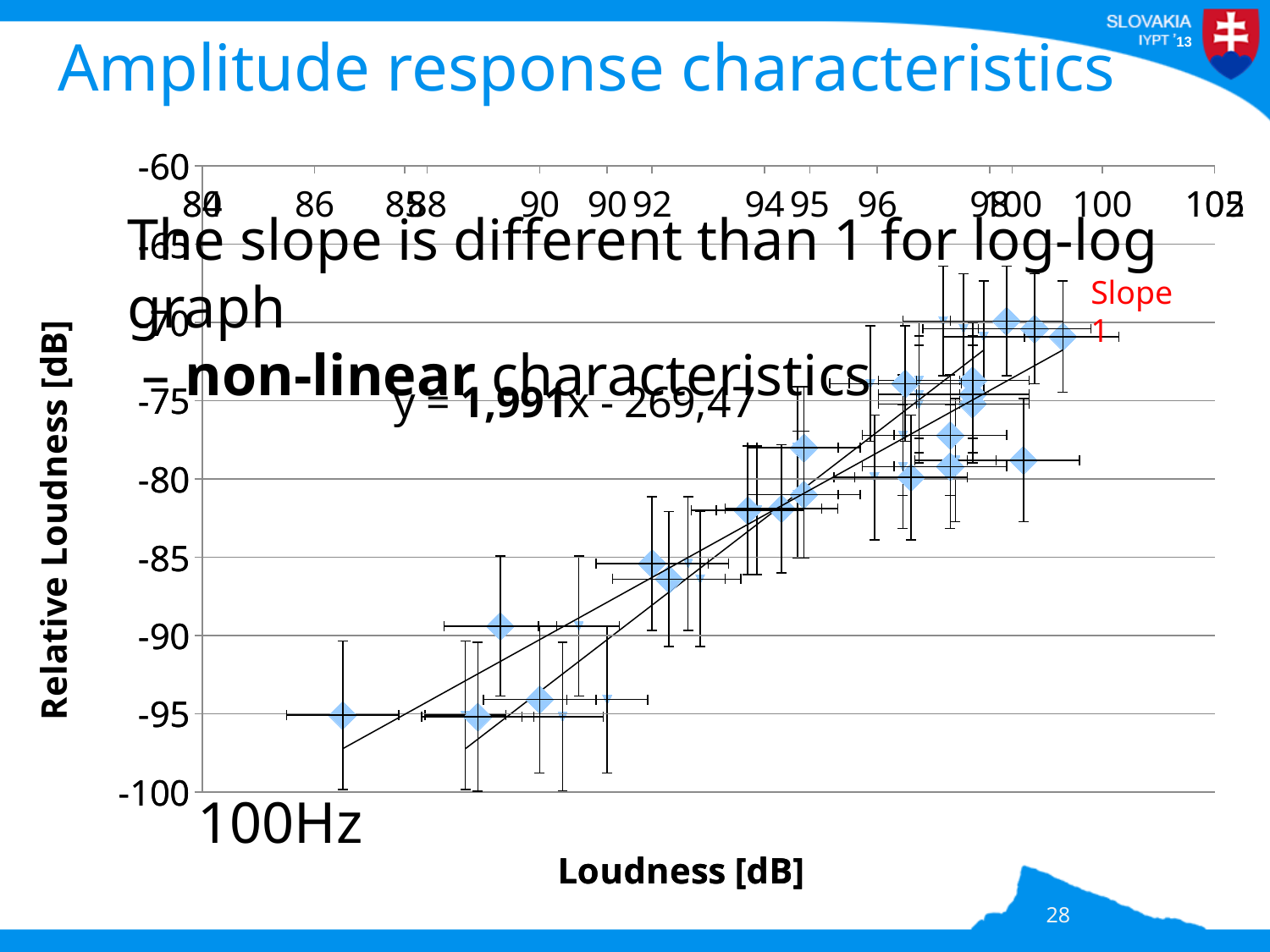
Do the plotted relative loudness values rise or fall as loudness increases along the x axis? rise Is the relative loudness of the leftmost data point greater or less than -90? less What is the highest tick value shown on the vertical axis? -60 What is the slope of the fitted trendline shown in the equation on the chart? 1,991 What is the lowest tick value shown on the vertical axis? -100 Which frequency is the chart labelled with? 100Hz Is the relative loudness of the rightmost data point greater or less than -75? greater What is the intercept in the trendline equation shown on the chart? -269,47 What is the title of the vertical axis of the chart? Relative Loudness [dB] What kind of chart is shown on the slide? scatter chart What is the title of the horizontal axis of the chart? Loudness [dB]